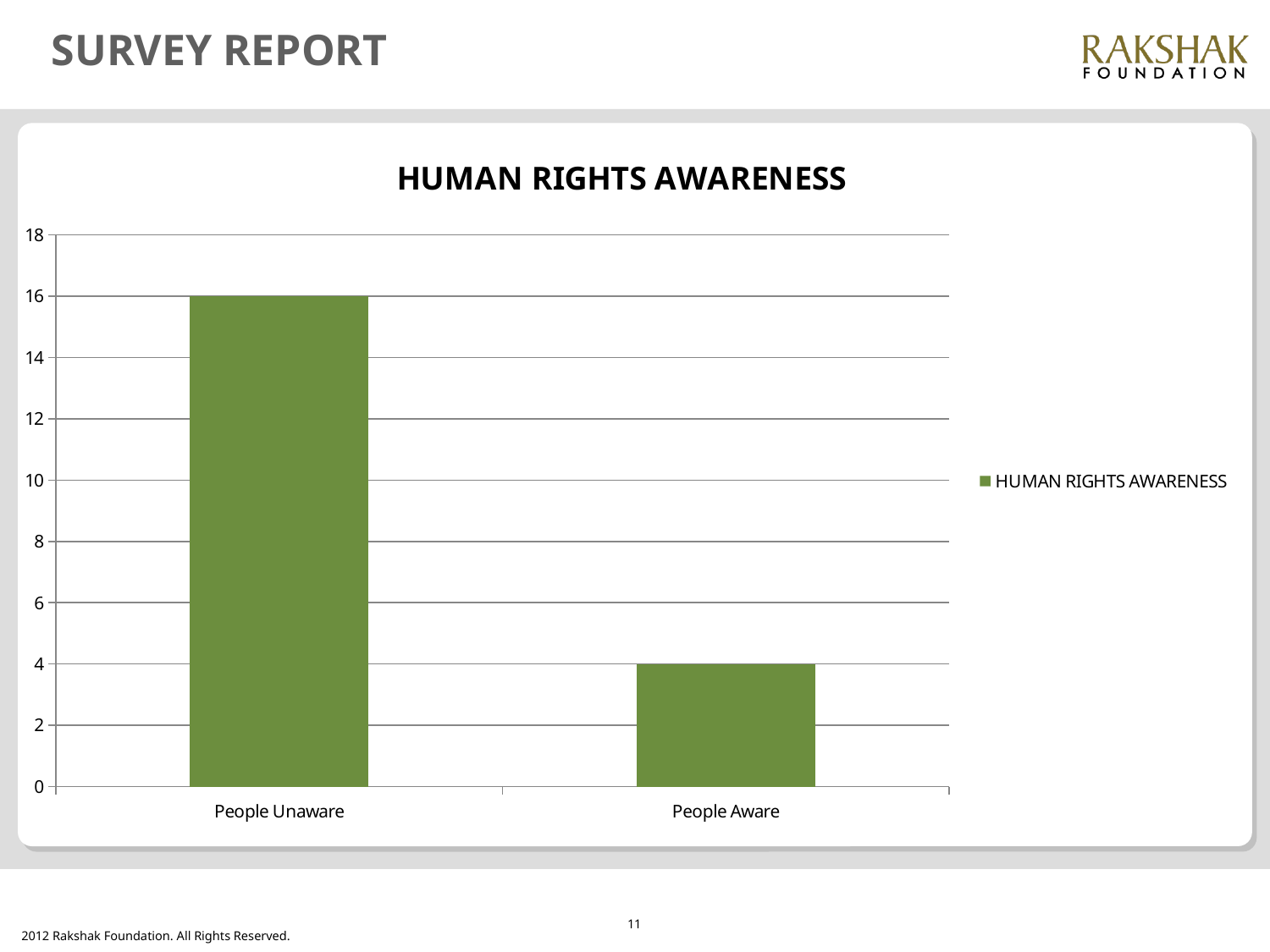
Is the value for People Aware greater or less than 6? less What is the title of the chart? HUMAN RIGHTS AWARENESS Is the value for People Unaware greater or less than 10? greater Which is larger, the value for People Unaware or the value for People Aware? People Unaware How many series does the legend list? 1 Which category has the highest value? People Unaware How many categories are shown on the x axis? 2 What kind of chart is shown on the slide? Bar chart What is the value for People Aware? 4 Which category has the lowest value? People Aware What is the value for People Unaware? 16 What is the difference between the values for People Unaware and People Aware? 12